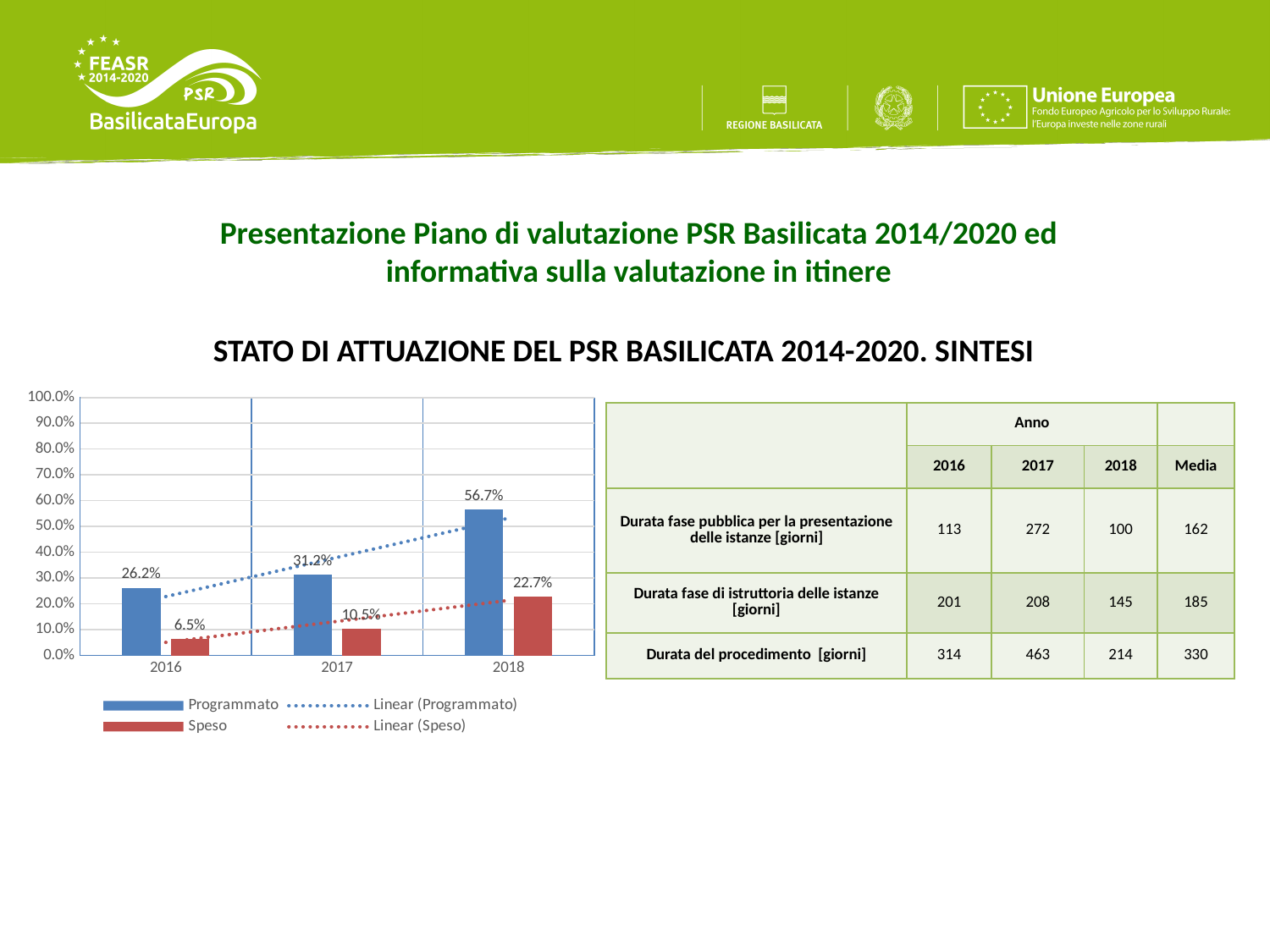
What is the difference between the Programmato values for 2017 and 2016? 5.0% What is the Speso value for 2017? 10.5% What is the Speso value for 2016? 6.5% Which is larger in 2017, the Programmato value or the Speso value? Programmato Is the Programmato value for 2018 greater or less than 50.0%? greater What is the difference between the Programmato and Speso values in 2018? 34.0% In which year is the Programmato value highest? 2018 How many years are shown on the x axis of the chart? 3 How many entries does the chart legend list? 4 In which year is the Speso value lowest? 2016 What is the Programmato value for 2018? 56.7% Does the Speso value rise or fall from 2016 to 2018? rise